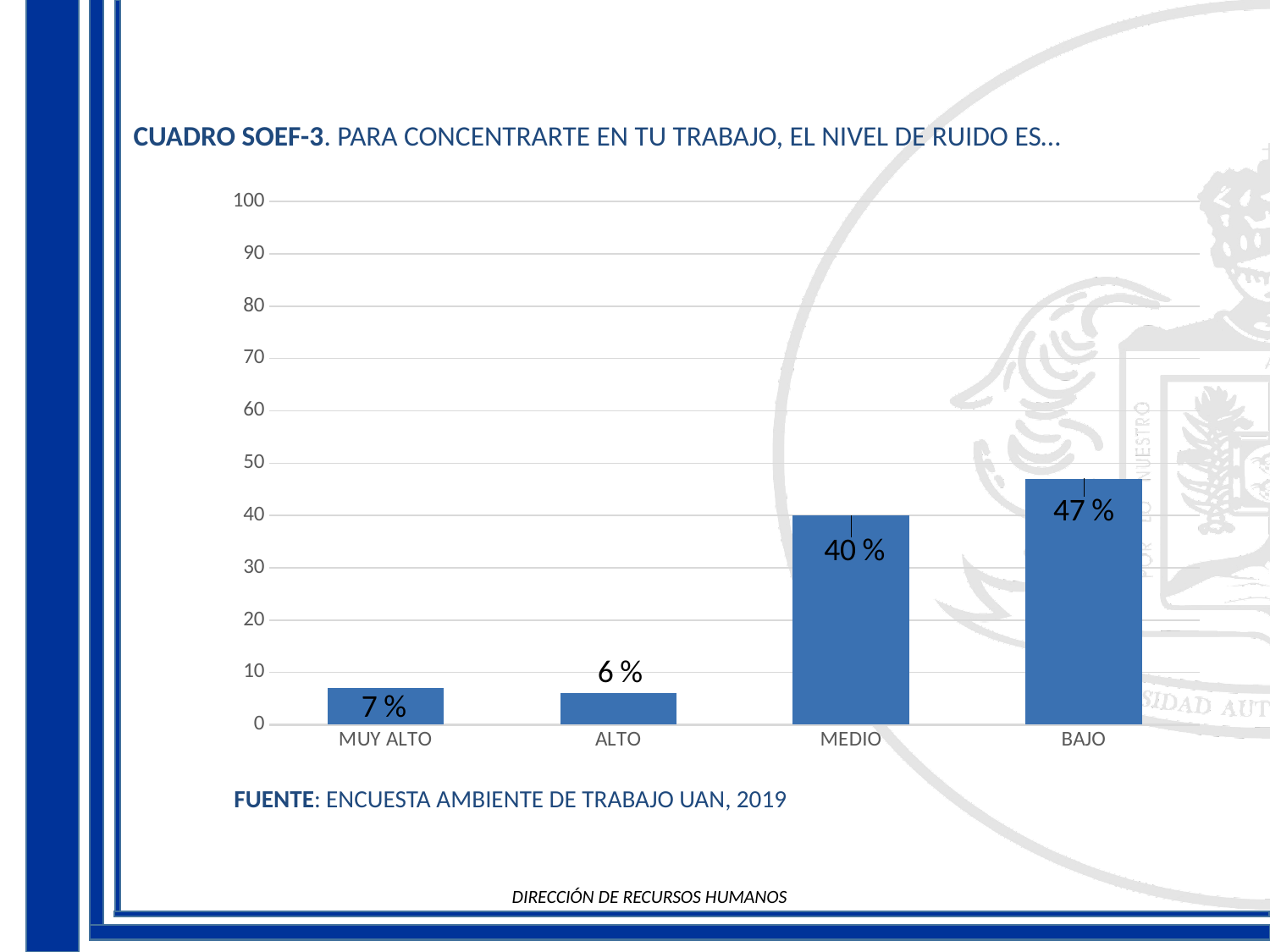
What is the value for MEDIO? 40 % Is the value for MEDIO greater or less than 50? less Which is larger, the value for MUY ALTO or the value for ALTO? MUY ALTO What kind of chart is shown on the slide? bar chart What is the value for MUY ALTO? 7 % What is the value for BAJO? 47 % Which category has the highest value? BAJO What is the difference between the values for BAJO and MEDIO? 7 % Which category has the lowest value? ALTO What source is cited below the chart? ENCUESTA AMBIENTE DE TRABAJO UAN, 2019 How many categories are shown on the x axis? 4 What is the value for ALTO? 6 %